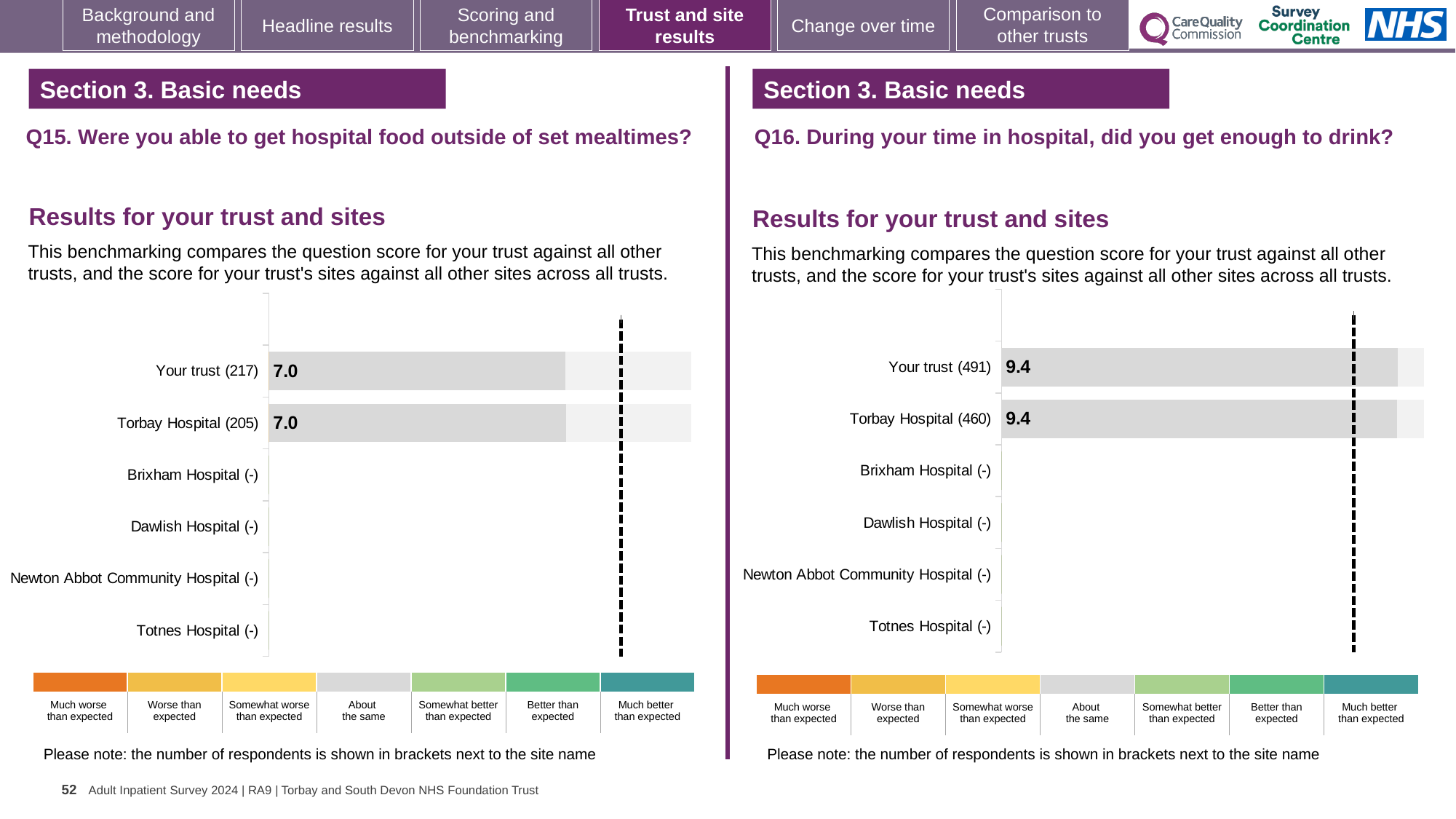
On the Q15 chart (left), how many respondents are shown in brackets for Your trust? 217 On the Q15 chart (left), what is the score for Your trust? 7.0 On the Q16 chart (right), what is the score for Torbay Hospital? 9.4 What kind of chart is the Q16 chart (right)? Bar chart On the Q15 chart (left), how many categories have a plotted bar? 2 On the Q16 chart (right), what is the score for Your trust? 9.4 On the Q15 chart (left), how many categories does the colour key below the chart list? 7 On the Q15 chart (left), what is the difference between the scores for Your trust and Torbay Hospital? 0.0 On the Q16 chart (right), how many site or trust categories are listed on the vertical axis? 6 On the Q16 chart (right), which site has no score shown, Brixham Hospital or Torbay Hospital? Brixham Hospital On the Q16 chart (right), how many respondents are shown in brackets for Torbay Hospital? 460 On the Q15 chart (left), what is the score for Torbay Hospital? 7.0